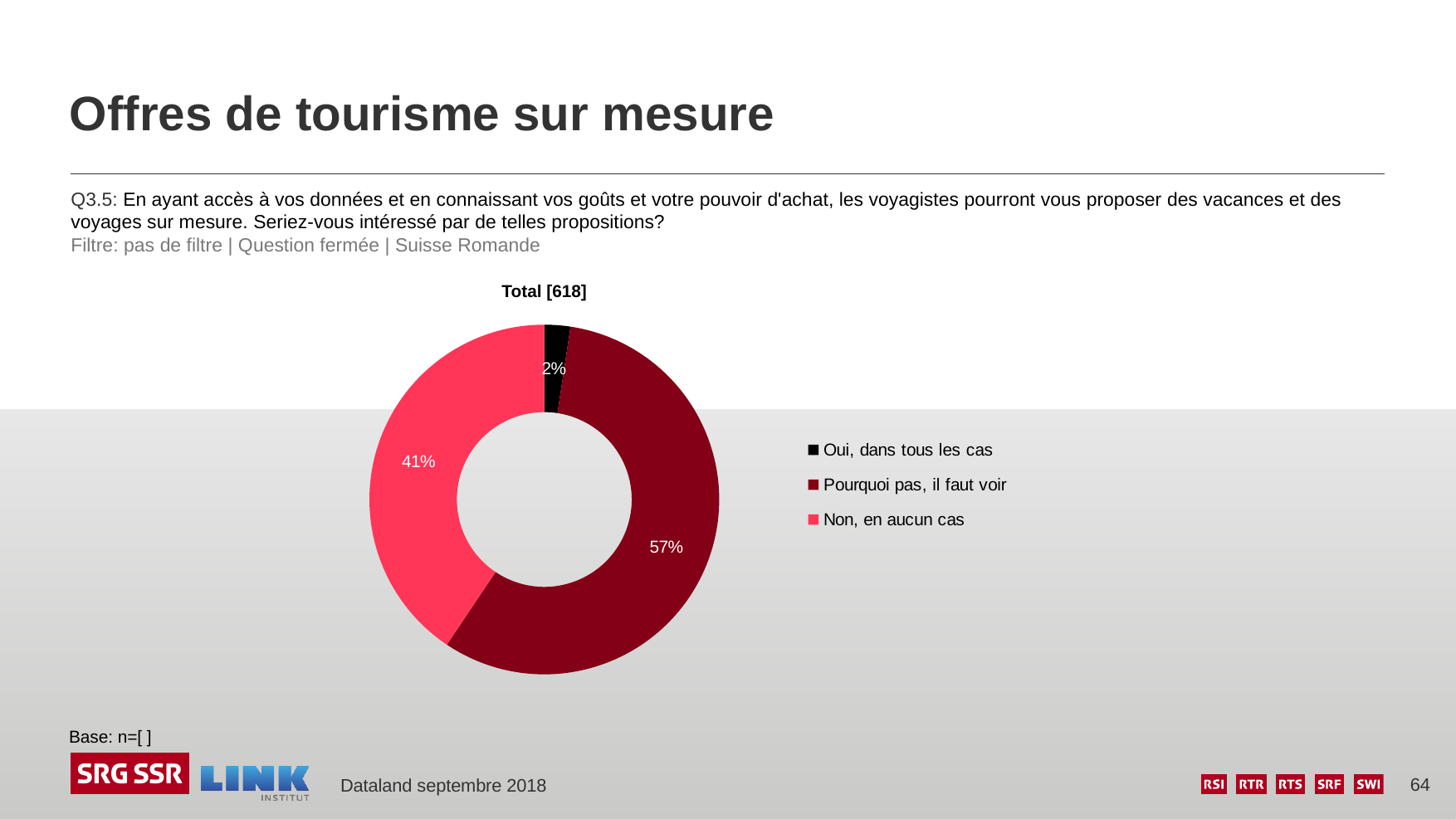
What type of chart is shown on the slide? Pie chart (doughnut) Which category has the smallest share? Oui, dans tous les cas What colour represents "Oui, dans tous les cas" in the chart? Black Which is larger: "Non, en aucun cas" or "Oui, dans tous les cas"? Non, en aucun cas What is the title of the chart? Total [618] What is the value for "Pourquoi pas, il faut voir"? 57% What is the value for "Oui, dans tous les cas"? 2% How many entries does the legend list? 3 How many categories does the chart show? 3 Which category has the largest share? Pourquoi pas, il faut voir What is the value for "Non, en aucun cas"? 41% What is the difference between "Pourquoi pas, il faut voir" and "Non, en aucun cas"? 16%